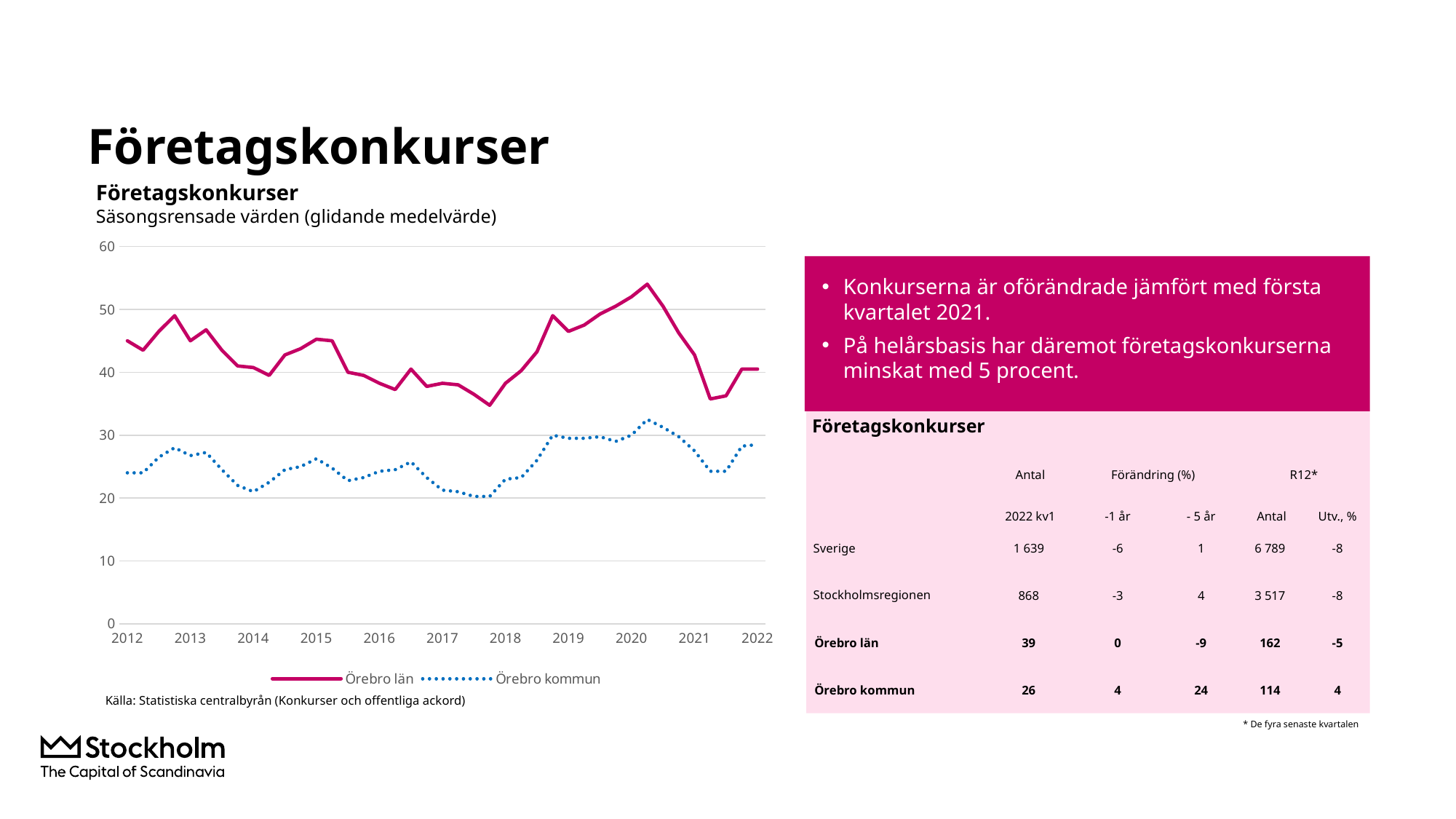
Is the value for Örebro kommun at the start of 2012 greater or less than 30? less Which two series are shown in the chart legend? Örebro län and Örebro kommun How many series does the chart legend list? 2 Which series has the higher values throughout the chart, Örebro län or Örebro kommun? Örebro län In which year does the Örebro län line reach its highest value? 2020 What kind of chart is shown on the slide? line chart What is the subtitle of the chart below 'Företagskonkurser'? Säsongsrensade värden (glidande medelvärde) Is the value for Örebro län at the start of 2012 greater or less than 40? greater How many year labels are shown on the x axis? 11 Does the Örebro län line rise or fall between 2018 and 2020? rise Is the peak value for Örebro kommun around 2020 greater or less than 30? greater